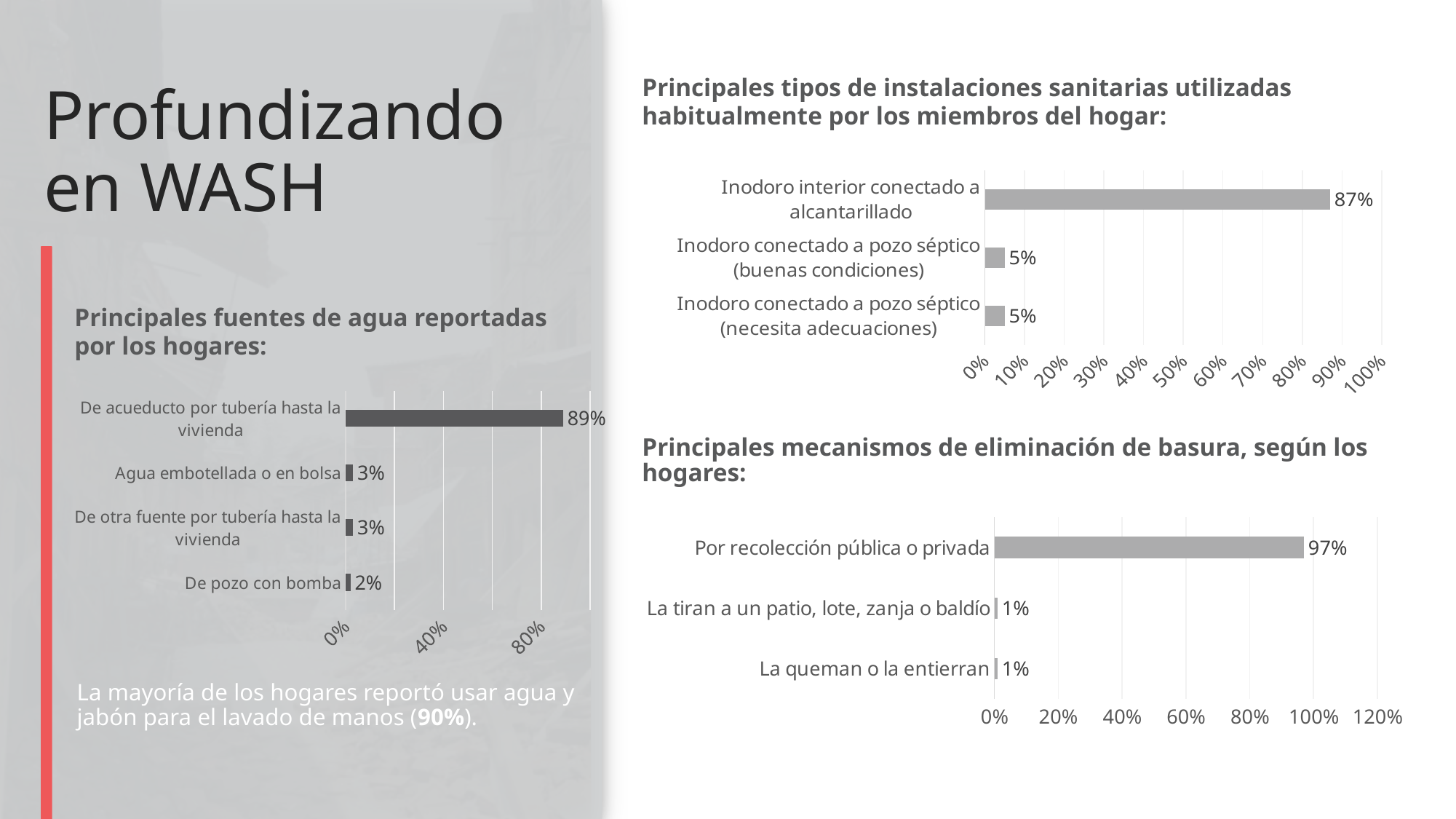
In the chart 'Principales fuentes de agua reportadas por los hogares', what is the value for 'De acueducto por tubería hasta la vivienda'? 89% In the chart 'Principales fuentes de agua reportadas por los hogares', what is the difference between 'De acueducto por tubería hasta la vivienda' and 'Agua embotellada o en bolsa'? 86% In the chart 'Principales fuentes de agua reportadas por los hogares', which category has the lowest value? De pozo con bomba In the chart 'Principales mecanismos de eliminación de basura, según los hogares', how many categories are shown? 3 In the chart 'Principales tipos de instalaciones sanitarias utilizadas habitualmente por los miembros del hogar', which category has the highest value? Inodoro interior conectado a alcantarillado In the chart 'Principales mecanismos de eliminación de basura, según los hogares', what is the value for 'Por recolección pública o privada'? 97% In the chart 'Principales mecanismos de eliminación de basura, según los hogares', what is the difference between 'Por recolección pública o privada' and 'La tiran a un patio, lote, zanja o baldío'? 96% In the chart 'Principales fuentes de agua reportadas por los hogares', how many categories are shown? 4 In the chart 'Principales mecanismos de eliminación de basura, según los hogares', what is the value for 'La queman o la entierran'? 1% In the chart 'Principales tipos de instalaciones sanitarias utilizadas habitualmente por los miembros del hogar', what is the value for 'Inodoro interior conectado a alcantarillado'? 87% In the chart 'Principales tipos de instalaciones sanitarias utilizadas habitualmente por los miembros del hogar', what is the value for 'Inodoro conectado a pozo séptico (buenas condiciones)'? 5% What kind of chart is 'Principales tipos de instalaciones sanitarias utilizadas habitualmente por los miembros del hogar'? Bar chart